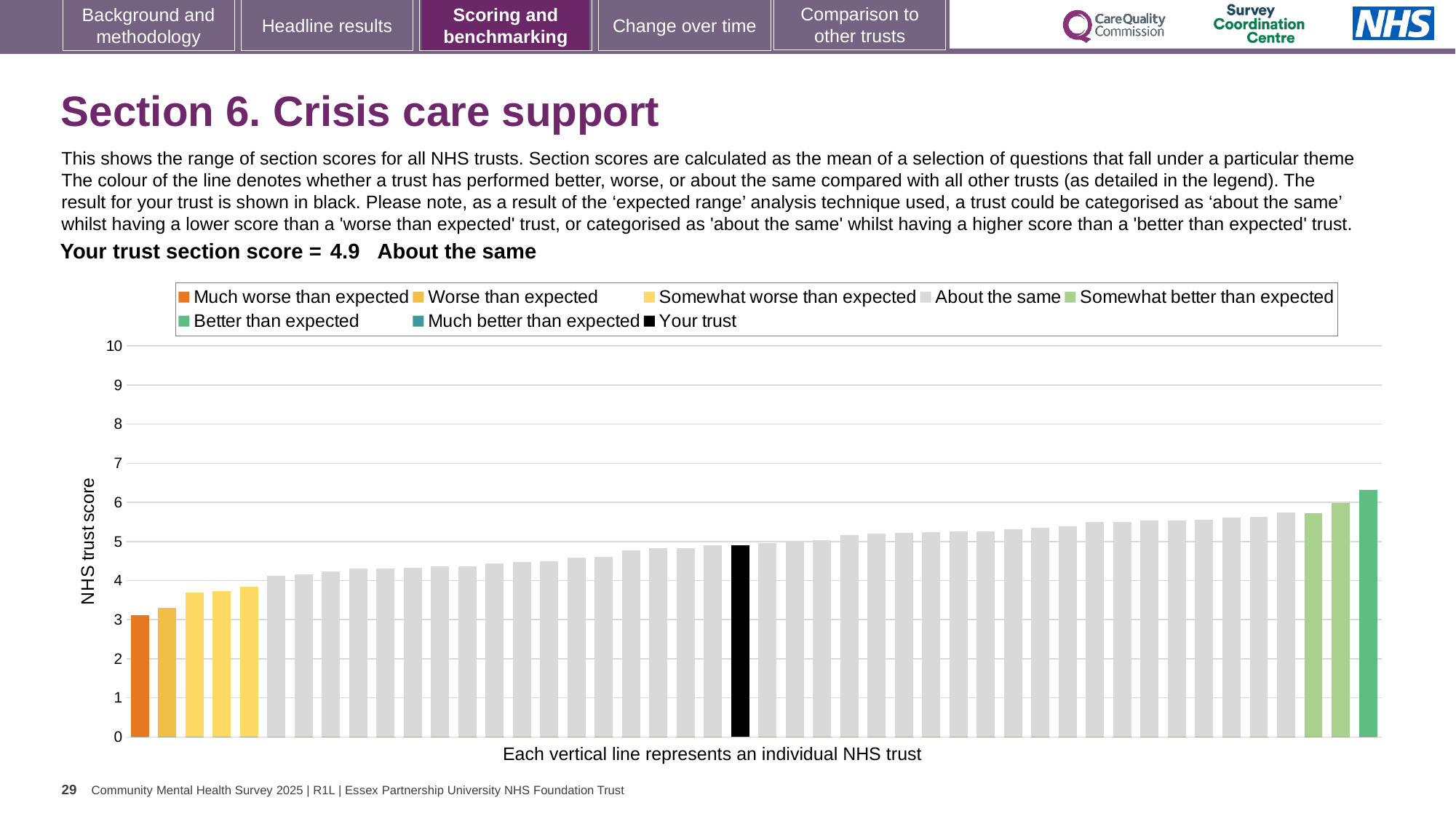
Is the value of the black 'Your trust' bar greater or less than 4? greater What is the section score for your trust shown on the slide? 4.9 Which legend category does the tallest bar belong to? Better than expected What kind of chart is shown on the slide? bar chart What is the label on the vertical axis of the chart? NHS trust score Is the value of the tallest bar greater or less than 6? greater How many entries does the chart legend list? 8 Is the value of the shortest (orange) bar greater or less than 4? less How many bars are coloured as 'Somewhat worse than expected'? 3 Do the bar values rise or fall from left to right along the x axis? rise Is the 'Your trust' bar taller or shorter than the 'Much worse than expected' bar? taller Which legend category does the shortest bar belong to? Much worse than expected